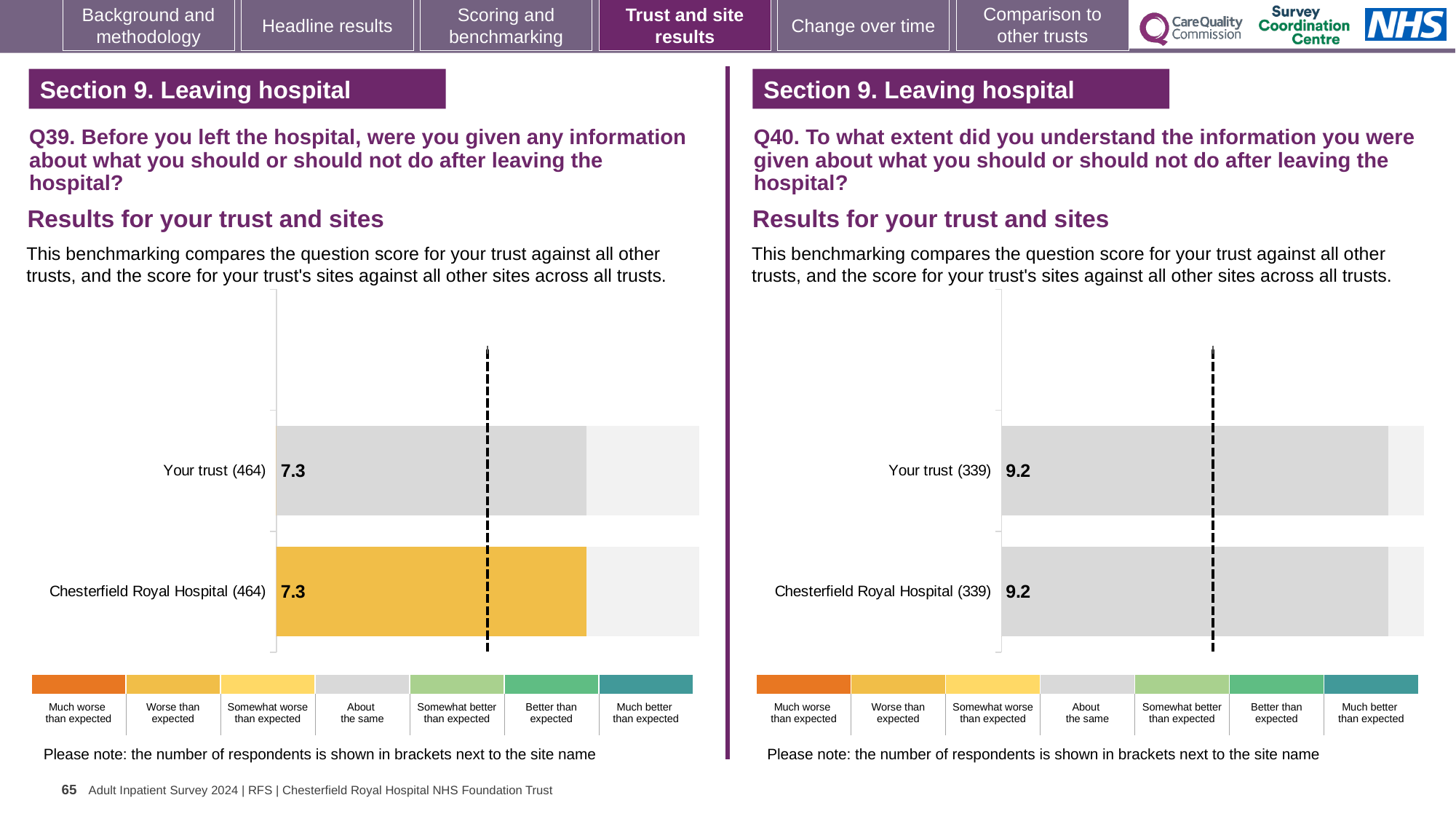
On the Q39 chart (left), what is the difference between the score for Your trust and the score for Chesterfield Royal Hospital? 0.0 What kind of chart is the Q39 chart (left)? Bar chart How many bars are plotted on the Q40 chart (right)? 2 How many bars are plotted on the Q39 chart (left)? 2 On the Q40 chart (right), what is the score for Chesterfield Royal Hospital? 9.2 On the Q39 chart (left), how many respondents are shown in brackets next to Chesterfield Royal Hospital? 464 On the Q40 chart (right), what is the score for Your trust? 9.2 On the Q40 chart (right), what is the difference between the score for Your trust and the score for Chesterfield Royal Hospital? 0.0 On the Q40 chart (right), how many respondents are shown in brackets next to Your trust? 339 On the Q39 chart (left), what colour is the bar for Chesterfield Royal Hospital? Orange/yellow On the Q39 chart (left), what is the score for Your trust? 7.3 On the Q39 chart (left), what is the score for Chesterfield Royal Hospital? 7.3